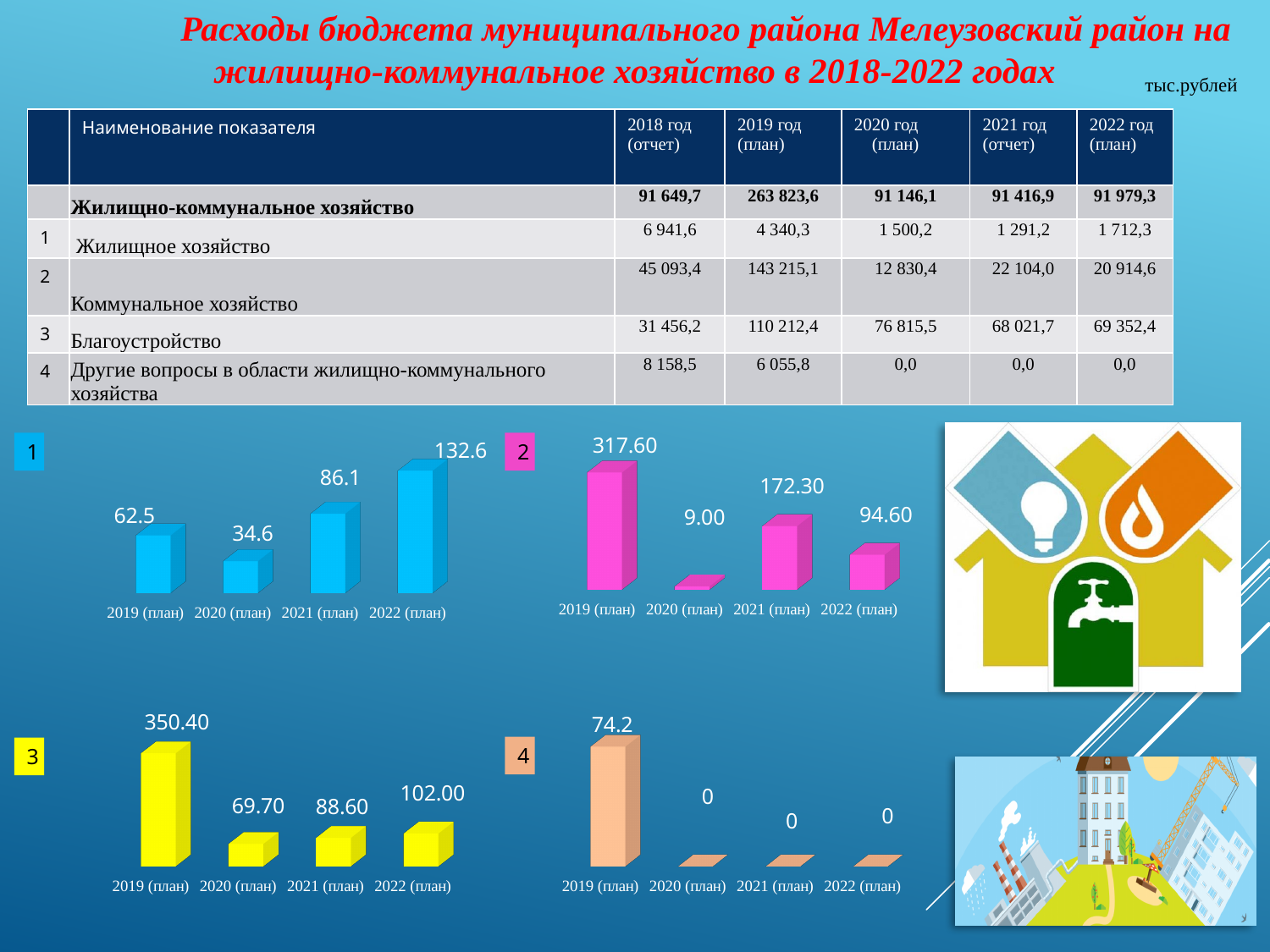
How many categories are shown in chart 1 (the blue chart at the top left)? 4 In chart 4 (the orange chart at the bottom), how many categories have a value of 0? 3 In chart 1 (the blue chart at the top left), what is the value for 2022 (план)? 132.6 In chart 1 (the blue chart at the top left), which category has the lowest value? 2020 (план) In chart 2 (the pink chart), which category has the highest value? 2019 (план) In chart 3 (the yellow chart at the bottom left), what is the value for 2020 (план)? 69.70 What kind of chart is chart 3 (the yellow chart at the bottom left)? bar chart In chart 3 (the yellow chart at the bottom left), what is the difference between the values for 2019 (план) and 2022 (план)? 248.40 In chart 2 (the pink chart), what is the difference between the values for 2021 (план) and 2022 (план)? 77.70 In chart 4 (the orange chart at the bottom), what is the value for 2019 (план)? 74.2 In chart 2 (the pink chart), what is the value for 2019 (план)? 317.60 In chart 3 (the yellow chart at the bottom left), which is larger, the value for 2021 (план) or 2022 (план)? 2022 (план)